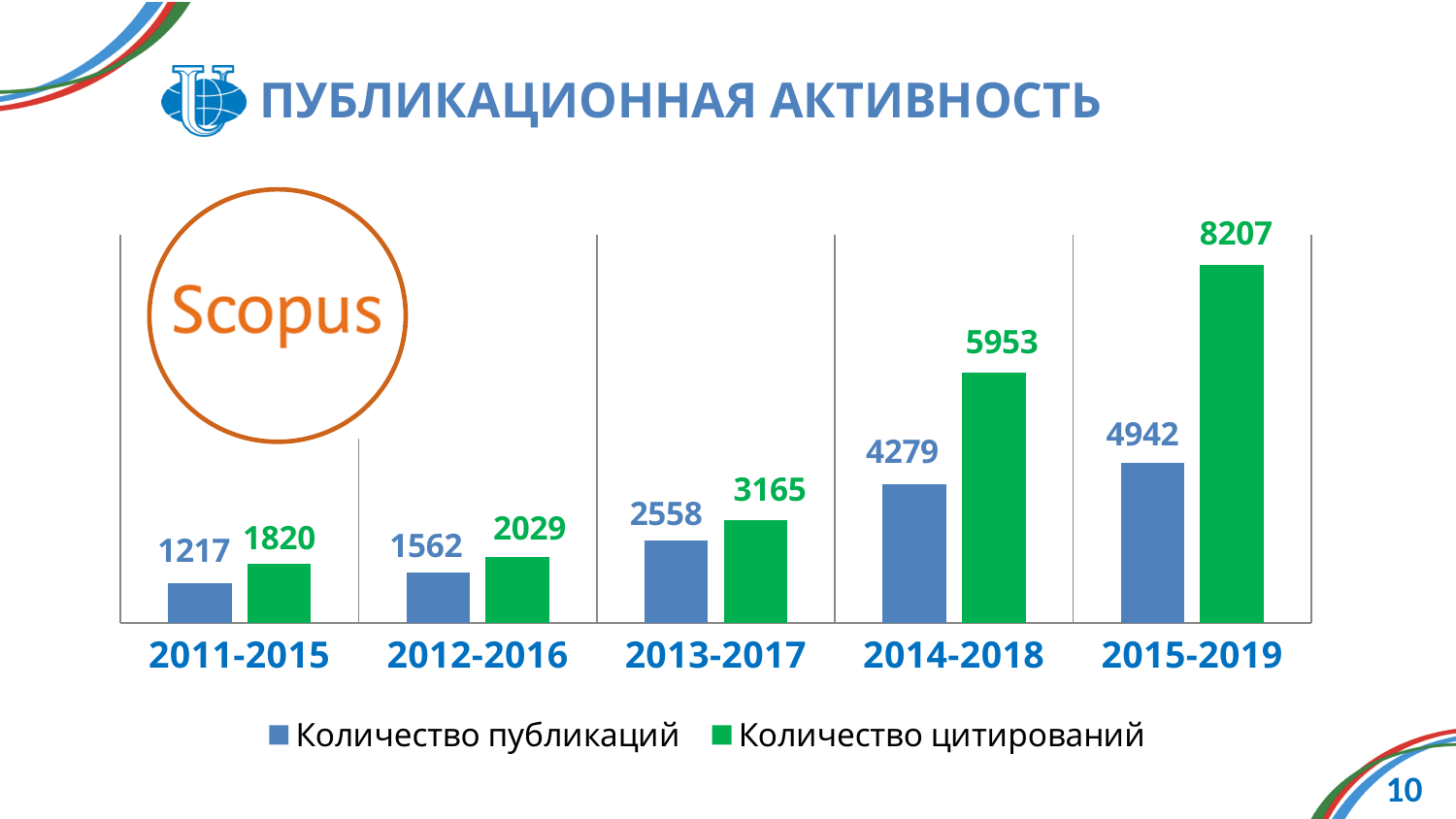
How many periods are shown on the x axis? 5 What kind of chart is shown on the slide? Bar chart What is the number of publications (Количество публикаций) for 2013-2017? 2558 Do the number of citations rise or fall from 2011-2015 to 2015-2019? Rise What is the number of citations (Количество цитирований) for 2011-2015? 1820 Which is larger: the number of publications for 2015-2019 or the number of citations for 2013-2017? Number of publications for 2015-2019 What is the difference between the number of citations and the number of publications for 2014-2018? 1674 What is the number of citations (Количество цитирований) for 2015-2019? 8207 What is the difference in the number of publications between 2015-2019 and 2012-2016? 3380 Which period has the highest number of citations (Количество цитирований)? 2015-2019 Which period has the lowest number of publications (Количество публикаций)? 2011-2015 How many series does the legend list? 2